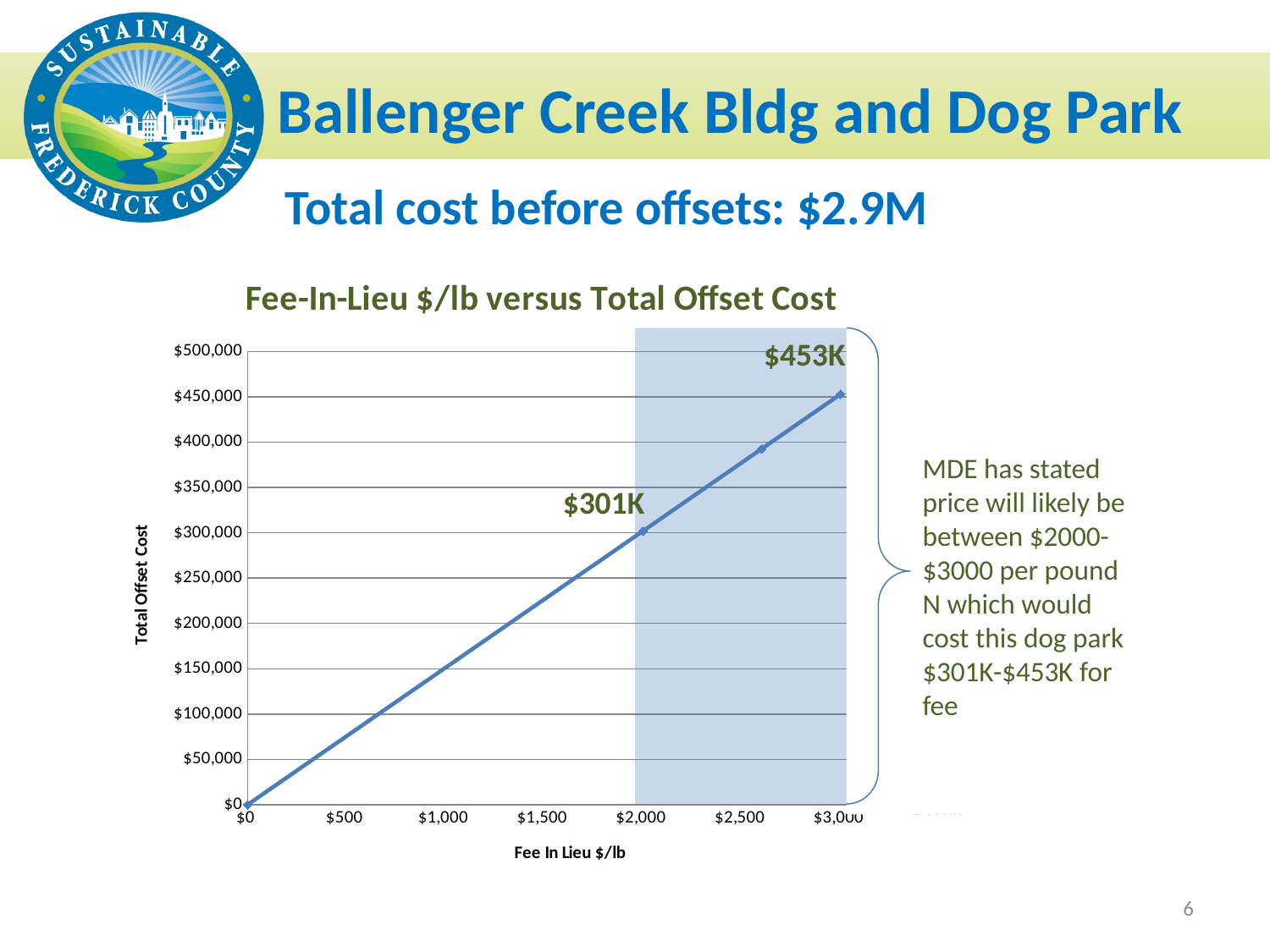
What total offset cost is labelled at a fee in lieu of $2,000 per pound? $301K What is the difference between the labelled total offset cost at $3,000/lb and at $2,000/lb? $152K Is the total offset cost at a fee in lieu of $1,000 greater or less than $250,000? less How many data points are plotted on the line? 4 What is the title of the chart? Fee-In-Lieu $/lb versus Total Offset Cost Which has the larger total offset cost: a fee in lieu of $2,000 or $3,000? $3,000 What kind of chart is shown on the slide? line chart Does the total offset cost rise or fall as the fee in lieu increases along the x axis? rises What total offset cost is labelled at a fee in lieu of $3,000 per pound? $453K At which fee in lieu value is the plotted total offset cost highest? $3,000 What is the label of the chart's y axis? Total Offset Cost Is the total offset cost at a fee in lieu of $3,000 greater or less than $500,000? less